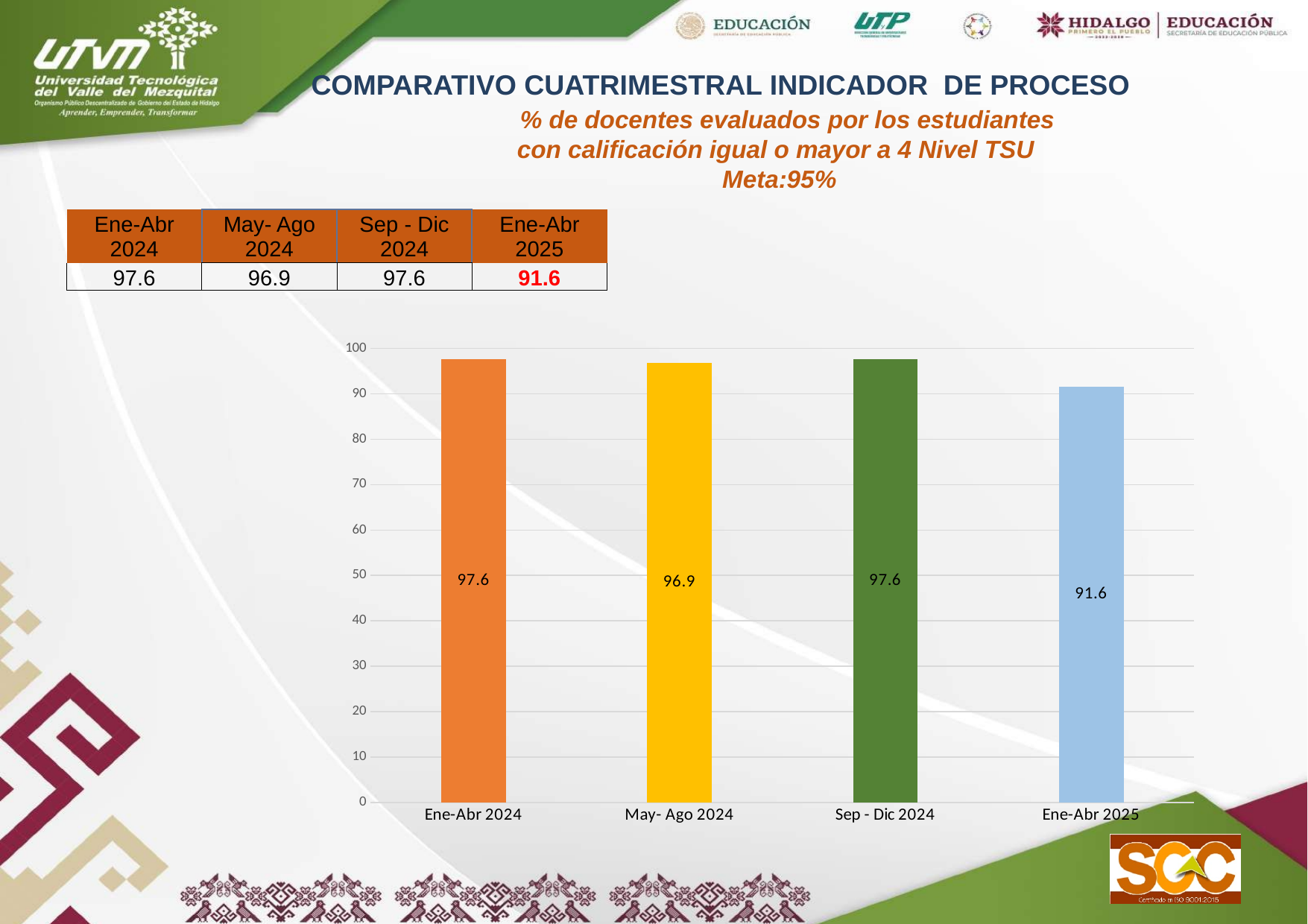
What is the target (Meta) stated in the chart subtitle? 95% What is the difference between the values for Sep - Dic 2024 and Ene-Abr 2025? 6.0 What is the value for Sep - Dic 2024? 97.6 Which is larger, the value for May- Ago 2024 or the value for Ene-Abr 2025? May- Ago 2024 Which period has the lowest value? Ene-Abr 2025 What is the value for Ene-Abr 2025? 91.6 How many periods are shown on the x axis? 4 What is the difference between the values for Ene-Abr 2024 and May- Ago 2024? 0.7 What kind of chart is shown on the slide? bar chart What colour is the bar for Ene-Abr 2025? light blue Is the value for Ene-Abr 2025 greater or less than 95? less What is the value for May- Ago 2024? 96.9